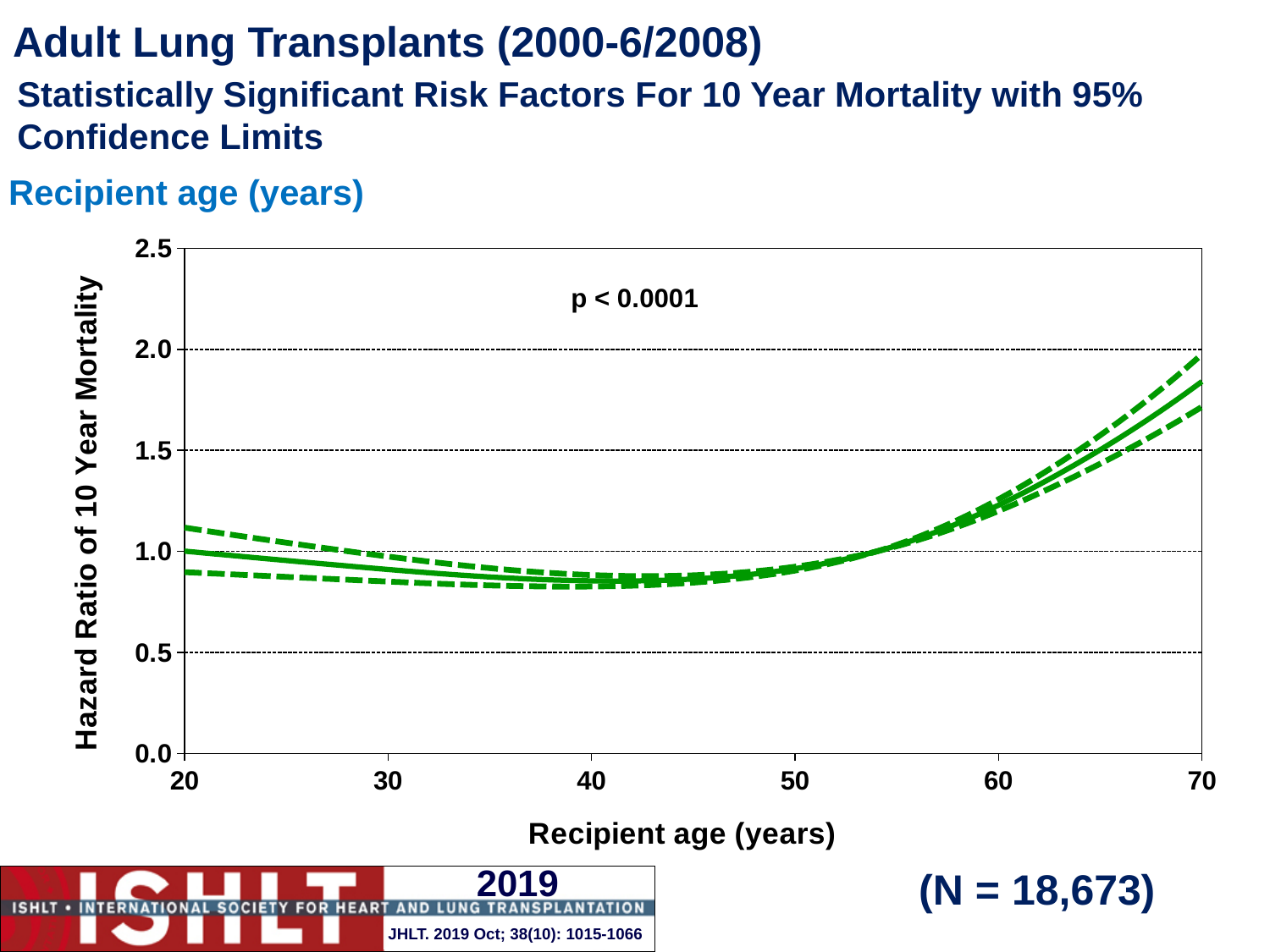
Is the hazard ratio of the solid line at a recipient age of 70 years greater or less than 1.5? greater Is the hazard ratio of the solid line at a recipient age of 40 years greater or less than 1.0? less What p-value is printed on the chart? p < 0.0001 Is the hazard ratio of the solid line at a recipient age of 60 years greater or less than 1.0? greater What is the label of the x axis? Recipient age (years) How many lines are plotted on the chart? 3 Does the hazard ratio rise or fall as recipient age increases from 50 to 70 years? rise What is the hazard ratio of the solid line at a recipient age of 20 years? 1.0 What kind of chart is shown on the slide? line chart At which recipient age shown on the x axis is the hazard ratio highest? 70 What is the label of the y axis? Hazard Ratio of 10 Year Mortality